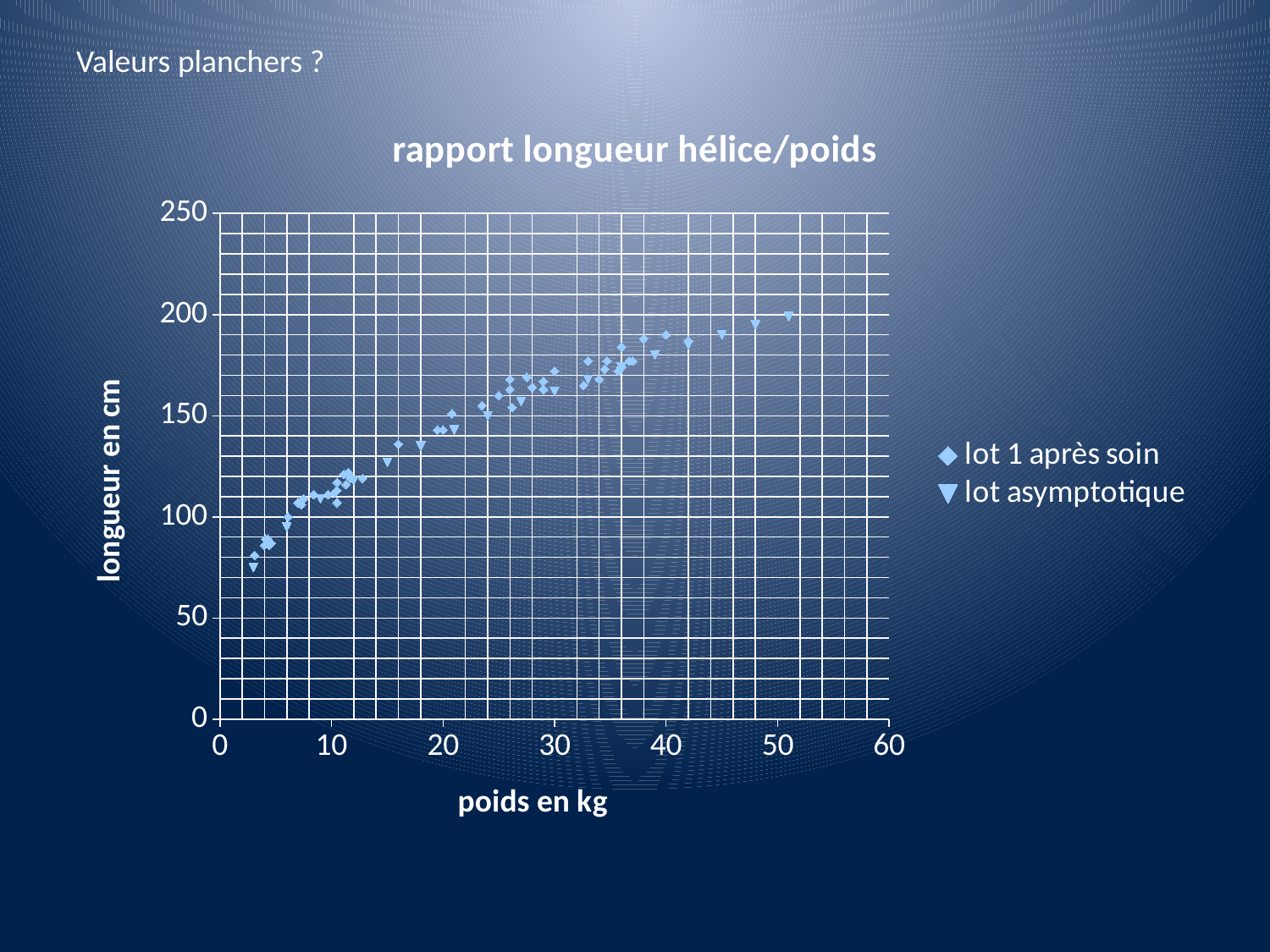
Is the longueur value for the points near 40 kg greater or less than 150? greater What is the title of the chart? rapport longueur hélice/poids Which series reaches the highest poids en kg value on the chart? lot asymptotique What are the two series named in the legend? lot 1 après soin, lot asymptotique Is the longueur value for the points near 20 kg greater or less than 100? greater How many series does the legend list? 2 Is the longueur value for the lot asymptotique point at about 50 kg greater or less than 150? greater Do the values of longueur en cm rise or fall as poids en kg increases? rise What kind of chart is shown on the slide? scatter chart